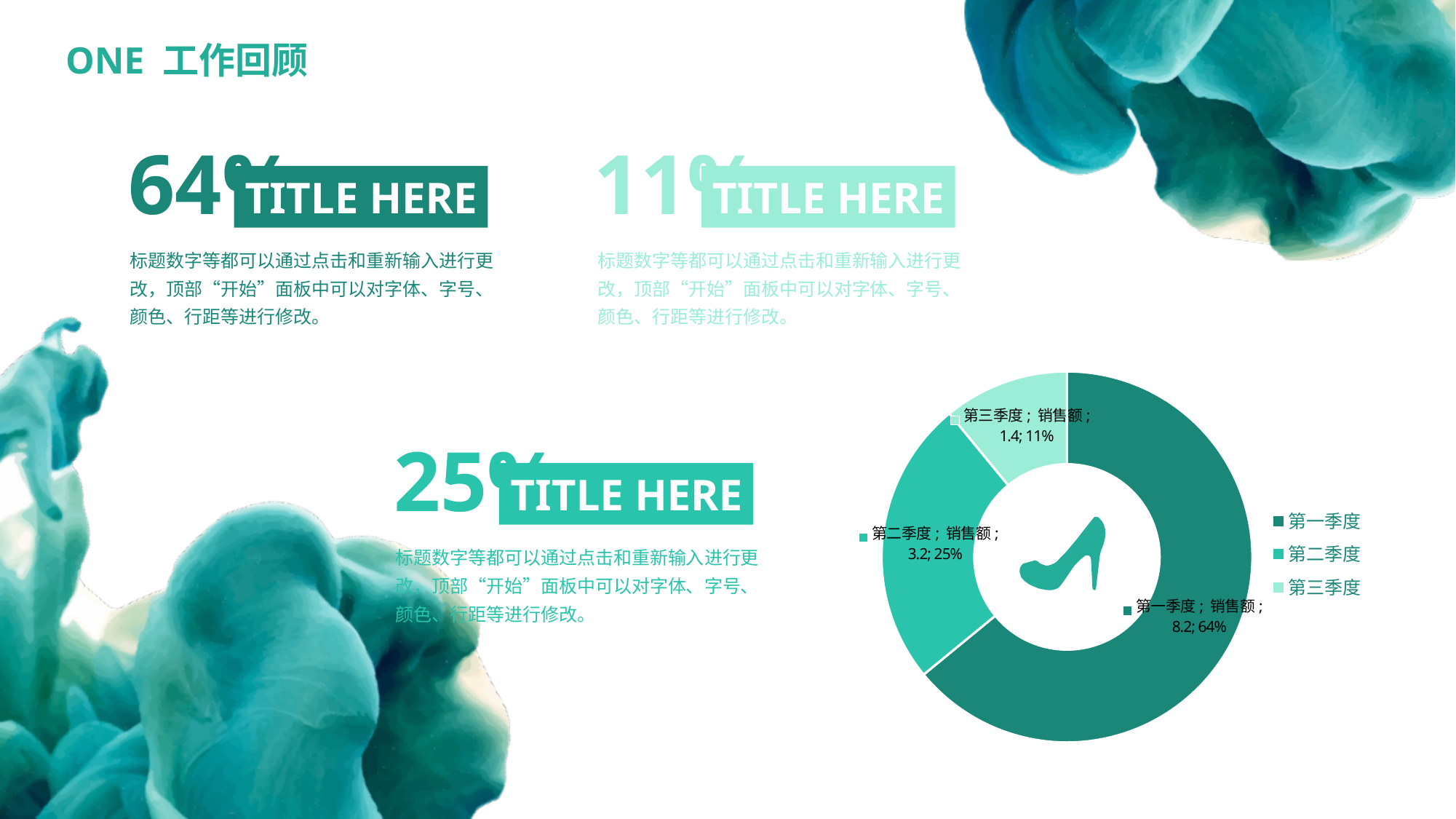
What is the sales value (销售额) for 第二季度 in the pie chart? 3.2 Which quarter has the largest slice in the pie chart? 第一季度 What is the difference between the sales values of 第一季度 and 第二季度? 5.0 What is the sales value (销售额) for 第一季度 in the pie chart? 8.2 Which quarter has the smallest slice in the pie chart? 第三季度 What is the sales value (销售额) for 第三季度 in the pie chart? 1.4 What share of the pie does 第一季度 represent? 64% How many categories are shown in the pie chart? 3 What share of the pie does 第三季度 represent? 11% Which is larger, the sales value for 第二季度 or for 第三季度? 第二季度 What is the name of the data series shown in the pie chart's data labels? 销售额 What kind of chart is shown on the slide? doughnut chart